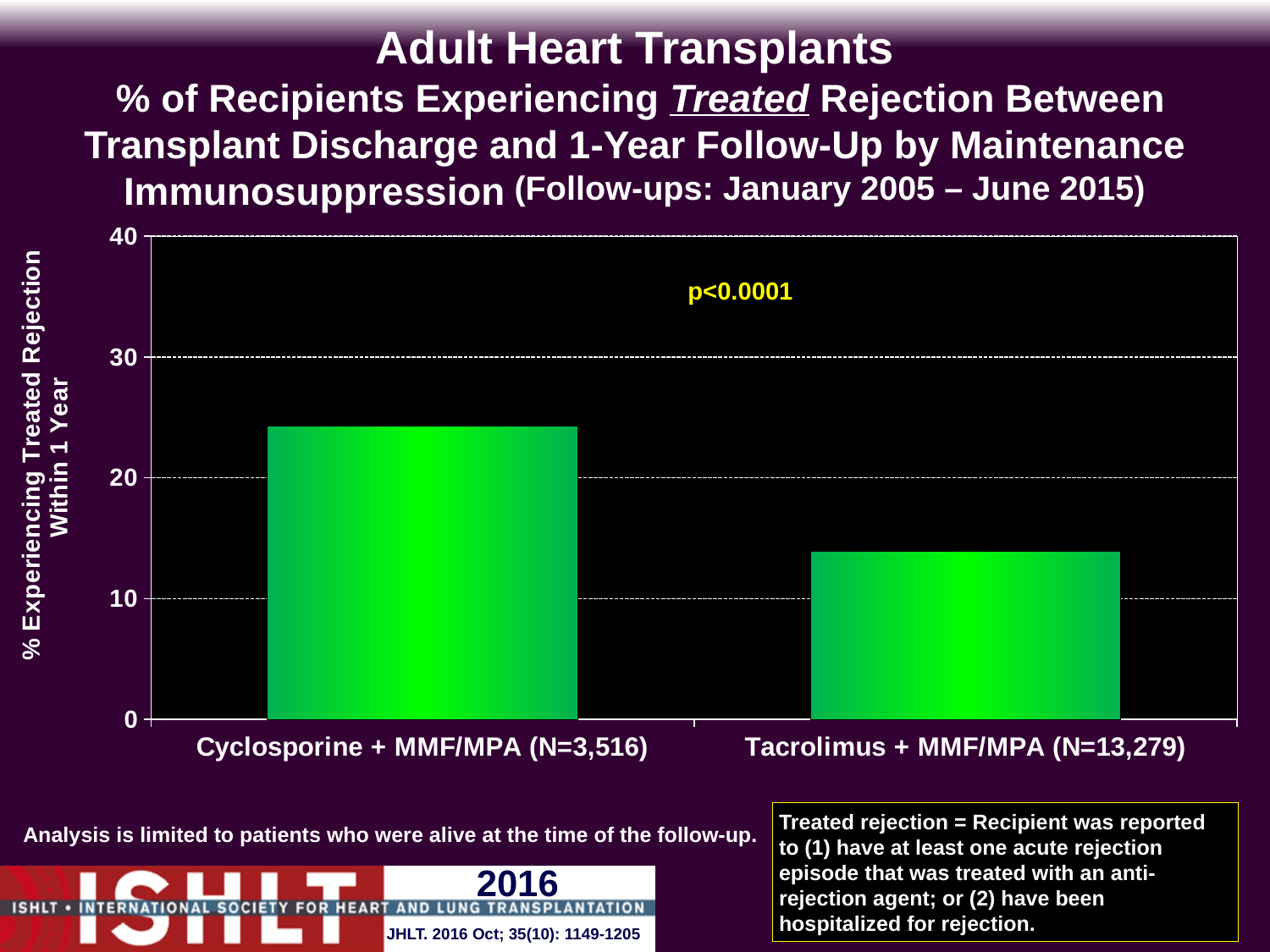
Which category has the lowest % experiencing treated rejection within 1 year? Tacrolimus + MMF/MPA (N=13,279) What is the N for the Tacrolimus + MMF/MPA group shown in the category label? 13,279 What is the maximum value shown on the y axis of the chart? 40 Is the value for Cyclosporine + MMF/MPA greater or less than 30? less Is the value for Tacrolimus + MMF/MPA greater or less than 20? less Is the value for Cyclosporine + MMF/MPA greater or less than 20? greater Which category has the highest % experiencing treated rejection within 1 year? Cyclosporine + MMF/MPA (N=3,516) How many maintenance immunosuppression categories are plotted on the chart? 2 Which is larger: the value for Cyclosporine + MMF/MPA or the value for Tacrolimus + MMF/MPA? Cyclosporine + MMF/MPA What p-value is printed on the chart? p<0.0001 What kind of chart is shown on the slide? bar chart